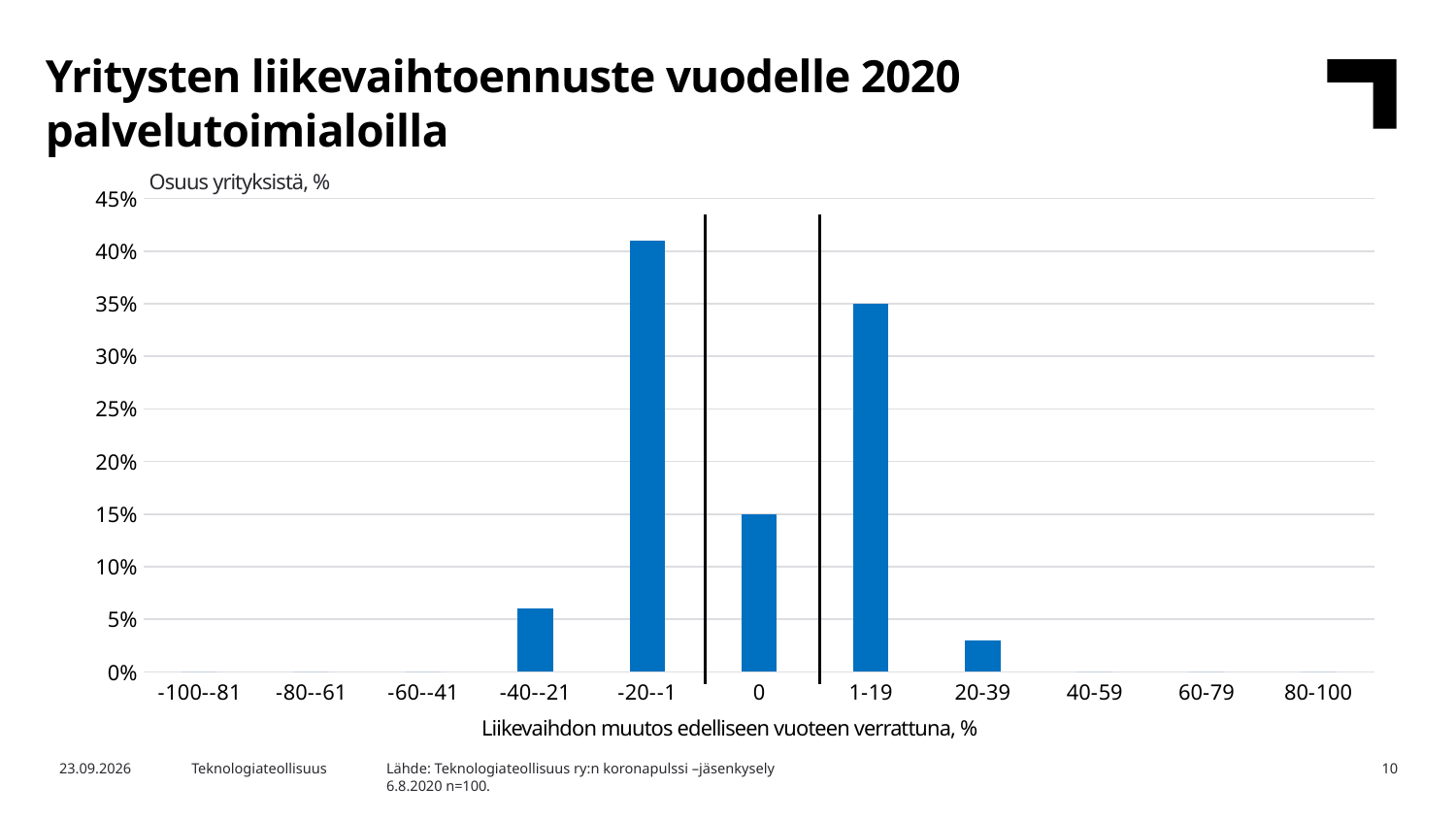
What is the difference between the values for 1-19 and 0? 20 percentage points Which is larger, the value for -20--1 or the value for 1-19? -20--1 How many categories are shown on the x axis? 11 What share of companies is shown for the category 1-19? 35% Which category has the highest bar? -20--1 Is the value for the category -20--1 greater or less than 40%? greater Is the value for the category 20-39 greater or less than 5%? less Is the value for the category -40--21 greater or less than 5%? greater What is the label of the horizontal axis? Liikevaihdon muutos edelliseen vuoteen verrattuna, % What kind of chart is shown on the slide? Bar chart What share of companies is shown for the category 0? 15% What is the label of the vertical axis? Osuus yrityksistä, %